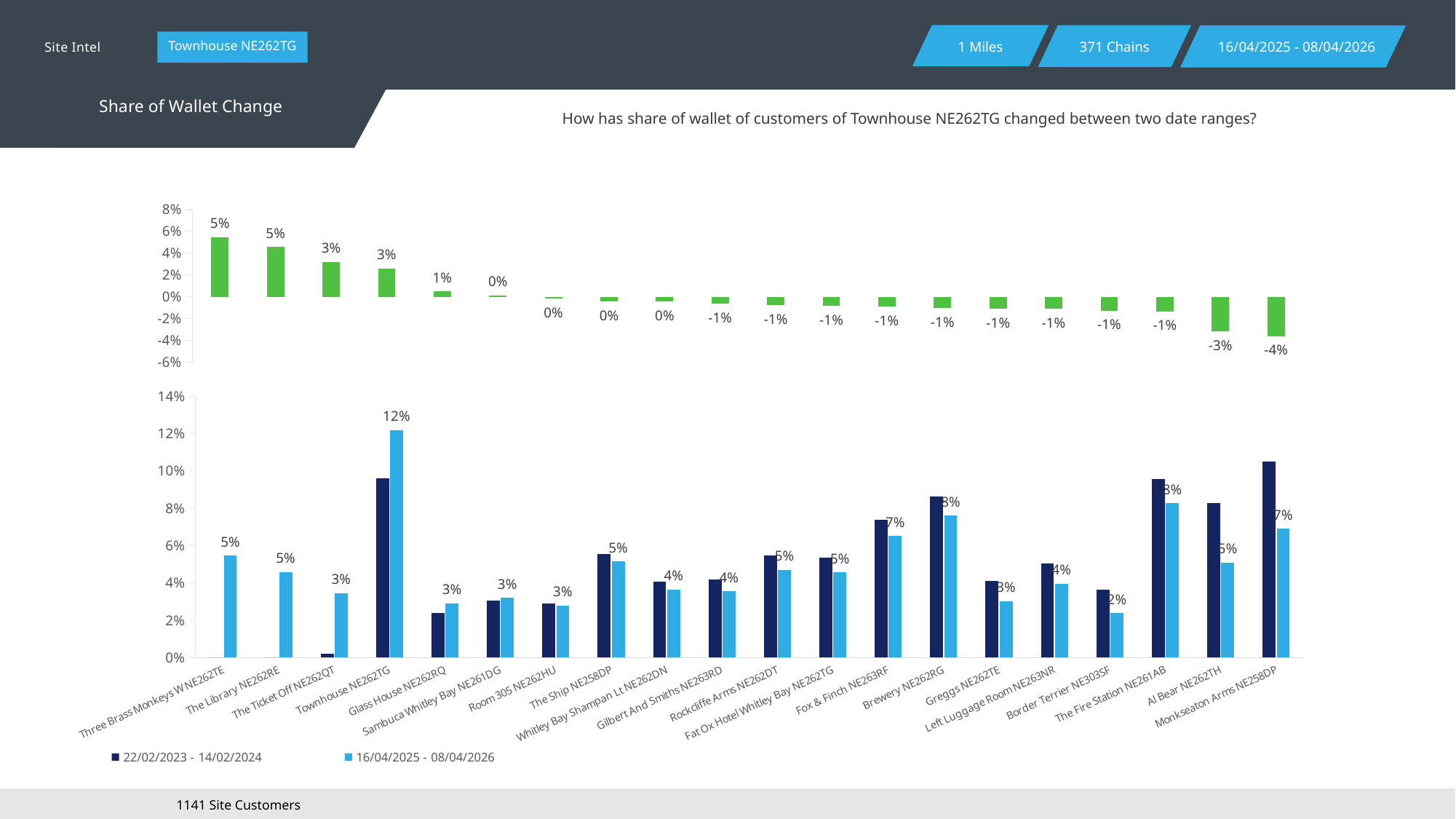
In the top chart, which venue has the lowest share of wallet change? Monkseaton Arms NE258DP How many series does the legend of the bottom chart list? 2 What kind of chart is the bottom chart? Bar chart In the top chart, do the share of wallet change values rise or fall from left to right? Fall In the bottom chart, what is the share of wallet for Townhouse NE262TG in the 16/04/2025 - 08/04/2026 period? 12% In the top chart, what is the share of wallet change for Monkseaton Arms NE258DP? -4% In the top chart, what is the share of wallet change for Al Bear NE262TH? -3% In the bottom chart, is the 22/02/2023 - 14/02/2024 value for Monkseaton Arms NE258DP greater or less than 10%? greater In the bottom chart, which venue has the highest share of wallet in the 16/04/2025 - 08/04/2026 period? Townhouse NE262TG How many venues are shown on the x axis of the bottom chart? 20 In the bottom chart, what is the difference between the 16/04/2025 - 08/04/2026 share of wallet for Townhouse NE262TG and Brewery NE262RG? 4% In the bottom chart, which is larger for the 16/04/2025 - 08/04/2026 period: Fox & Finch NE263RF or Border Terrier NE303SF? Fox & Finch NE263RF